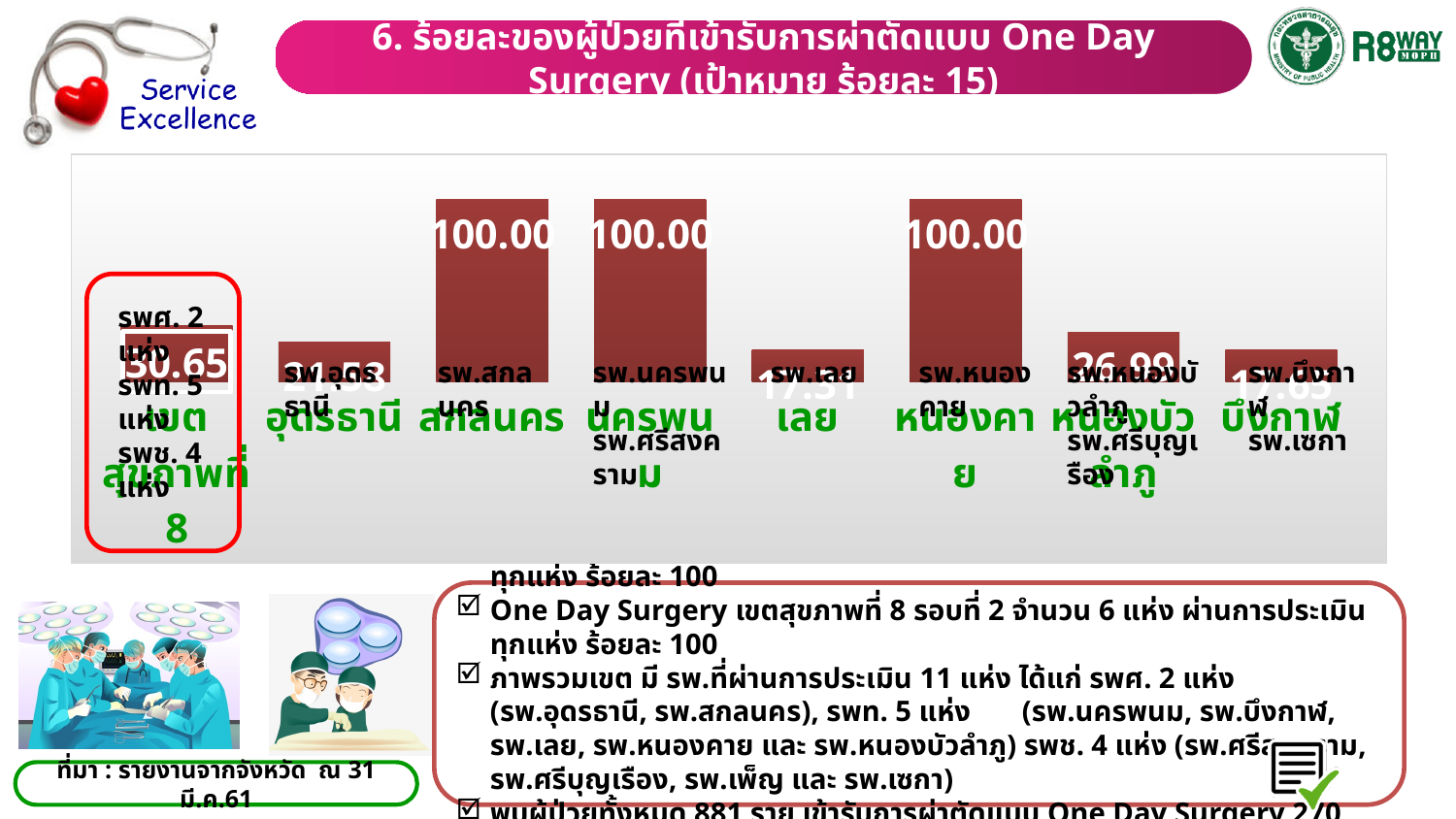
How many bars in the chart reach a value of 100.00? 3 What is the value shown for สกลนคร? 100.00 What kind of chart is shown on the slide? bar chart What is the value shown for หนองคาย? 100.00 Which has the larger value, หนองคาย or อุดรธานี? หนองคาย How many categories (bars) are plotted in the chart? 8 What is the difference between the values for สกลนคร and นครพนม? 0.00 What colour are the bars in the chart? dark red Which has the larger value, สกลนคร or เลย? สกลนคร What is the value shown for นครพนม? 100.00 Which has the larger value, นครพนม or บึงกาฬ? นครพนม According to the chart title, what is the target percentage (เป้าหมาย) for One Day Surgery? ร้อยละ 15